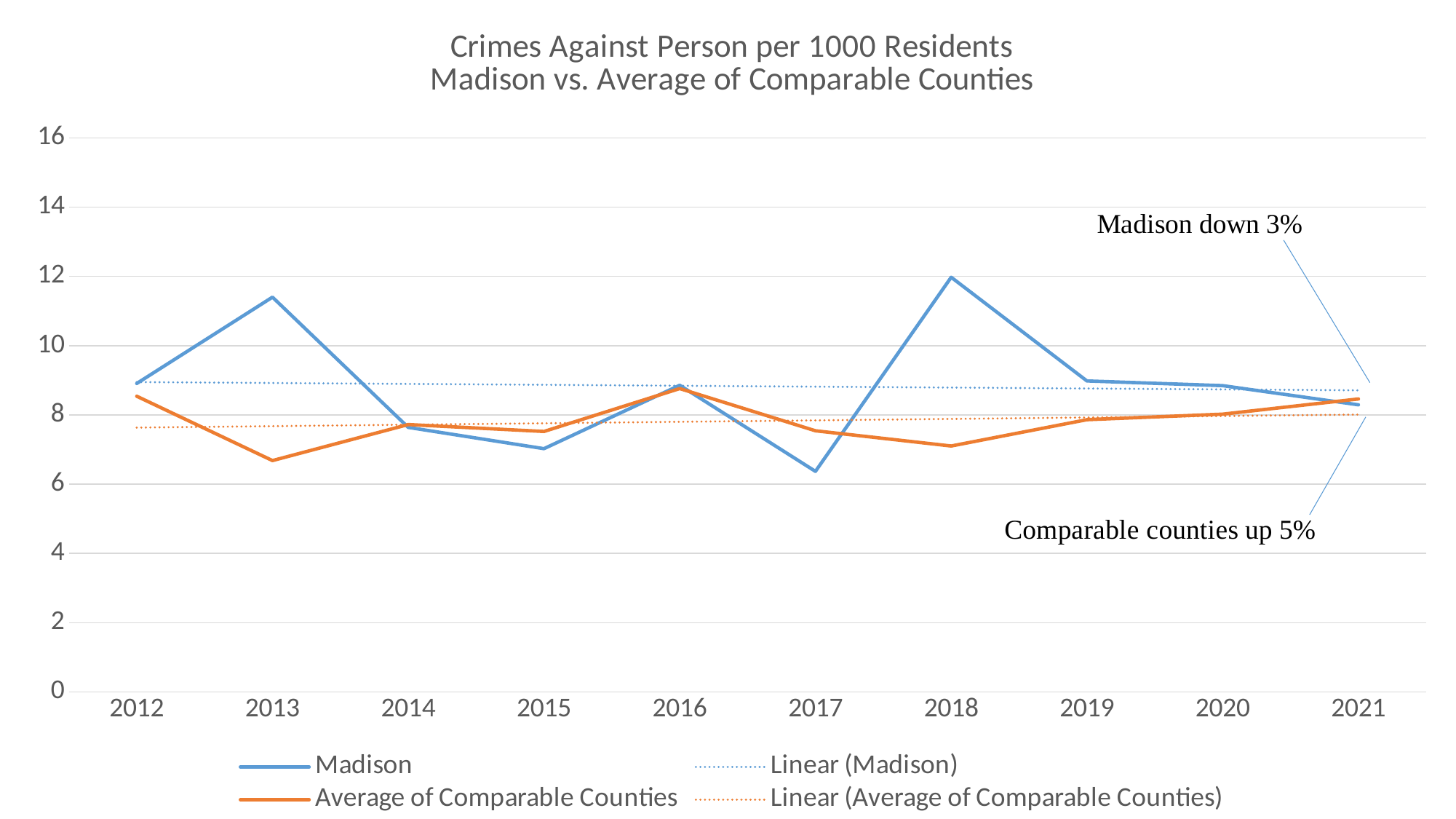
How many years are plotted along the x axis? 10 What kind of chart is shown on the slide? Line chart In which year does the Average of Comparable Counties series reach its lowest value? 2013 According to the annotation on the chart, by what percentage is Madison down? 3% Is the Madison value for 2018 greater or less than 10? greater How many entries does the legend list? 4 Is the Madison value for 2017 greater or less than 8? less In which year does the Madison series reach its lowest value? 2017 Is the Average of Comparable Counties value for 2013 greater or less than 8? less In 2017, which series has the higher value, Madison or Average of Comparable Counties? Average of Comparable Counties In 2013, which series has the higher value, Madison or Average of Comparable Counties? Madison In which year does the Madison series reach its highest value? 2018